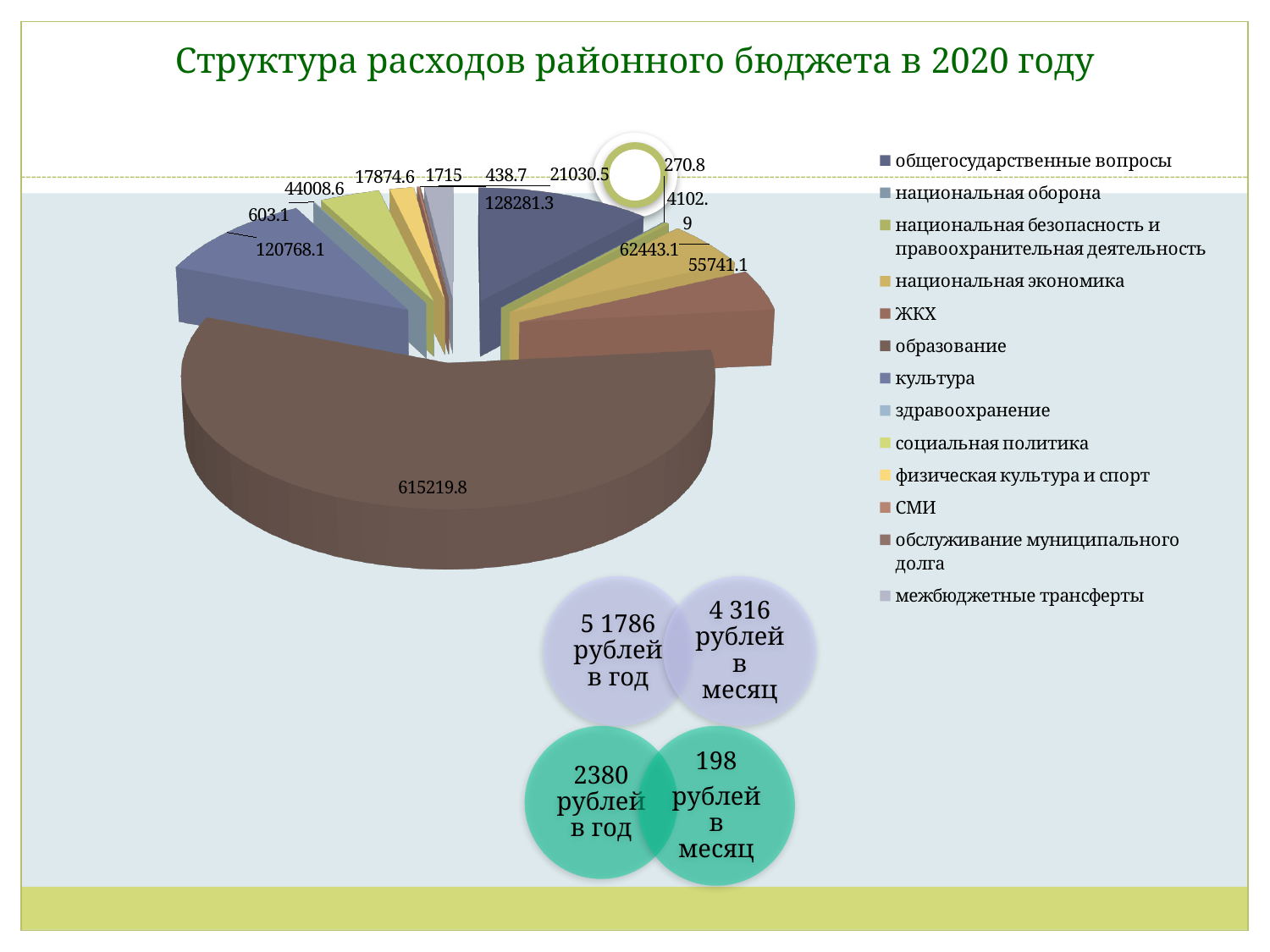
What is the value shown for общегосударственные вопросы? 128281.3 What is the value shown for культура? 120768.1 What is the difference between the values for общегосударственные вопросы and культура? 7513.2 Which category has the smallest value in the pie chart? национальная оборона Which category has the largest slice in the pie chart? образование How many categories does the legend of the pie chart list? 13 Which is larger: общегосударственные вопросы or культура? общегосударственные вопросы What is the value shown for межбюджетные трансферты? 21030.5 What is the value shown for социальная политика? 44008.6 What is the title of the chart? Структура расходов районного бюджета в 2020 году What is the value shown for образование? 615219.8 What kind of chart is shown on the slide? pie chart